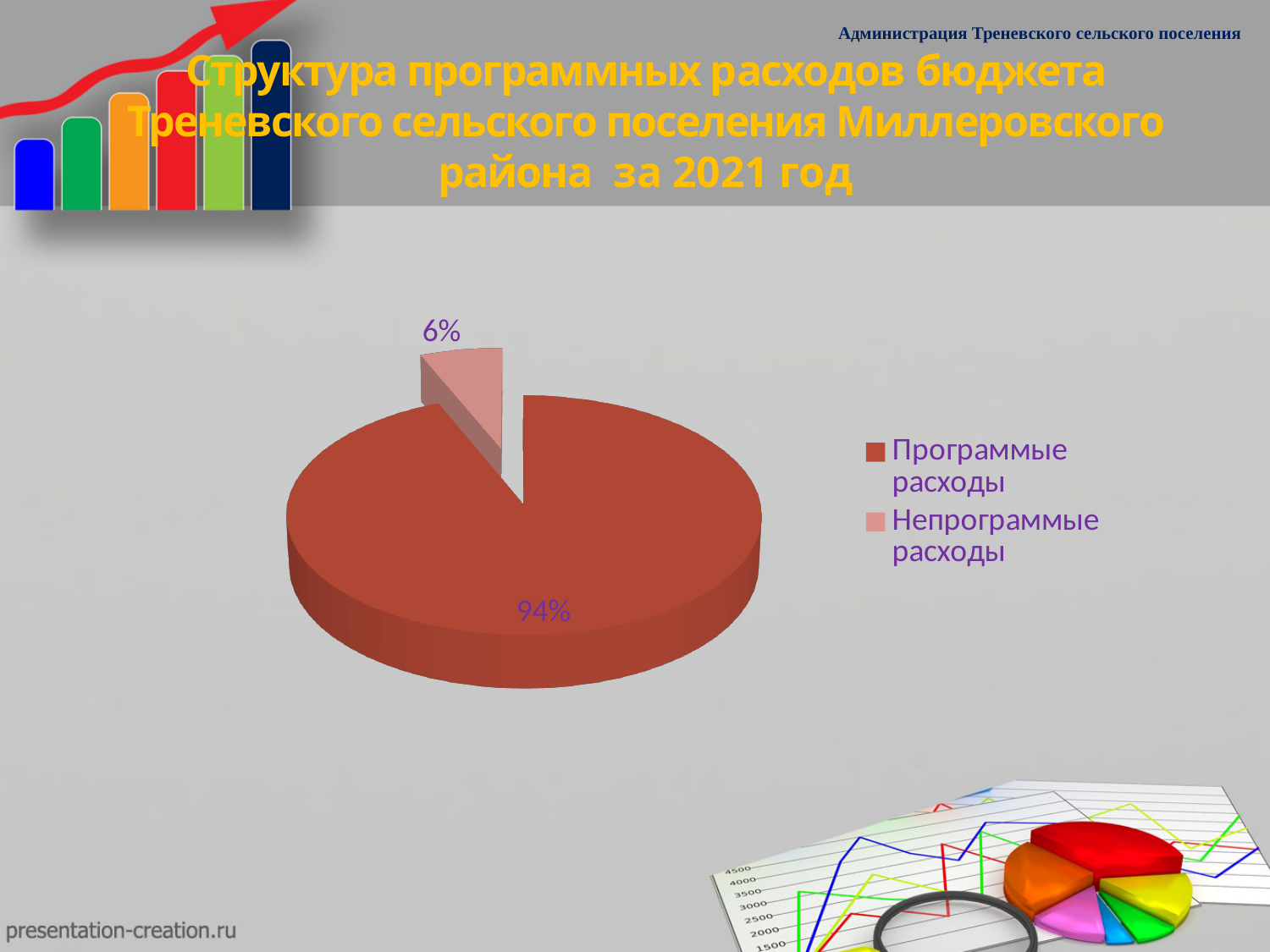
What is the total of the two percentages shown on the pie chart? 100% What share of the pie does Непрограммые расходы account for? 6% Which is larger: the share for Программые расходы or the share for Непрограммые расходы? Программые расходы Which category has the largest slice of the pie? Программые расходы Which legend entry is shown in the lighter pink colour? Непрограммые расходы Which category has the smallest slice of the pie? Непрограммые расходы How many slices does the pie chart have? 2 For which year does the slide title say the budget expenditure structure is shown? 2021 What share of the pie does Программые расходы account for? 94% What is the difference in percentage points between Программые расходы and Непрограммые расходы? 88 What kind of chart is shown on the slide? Pie chart How many entries does the legend list? 2